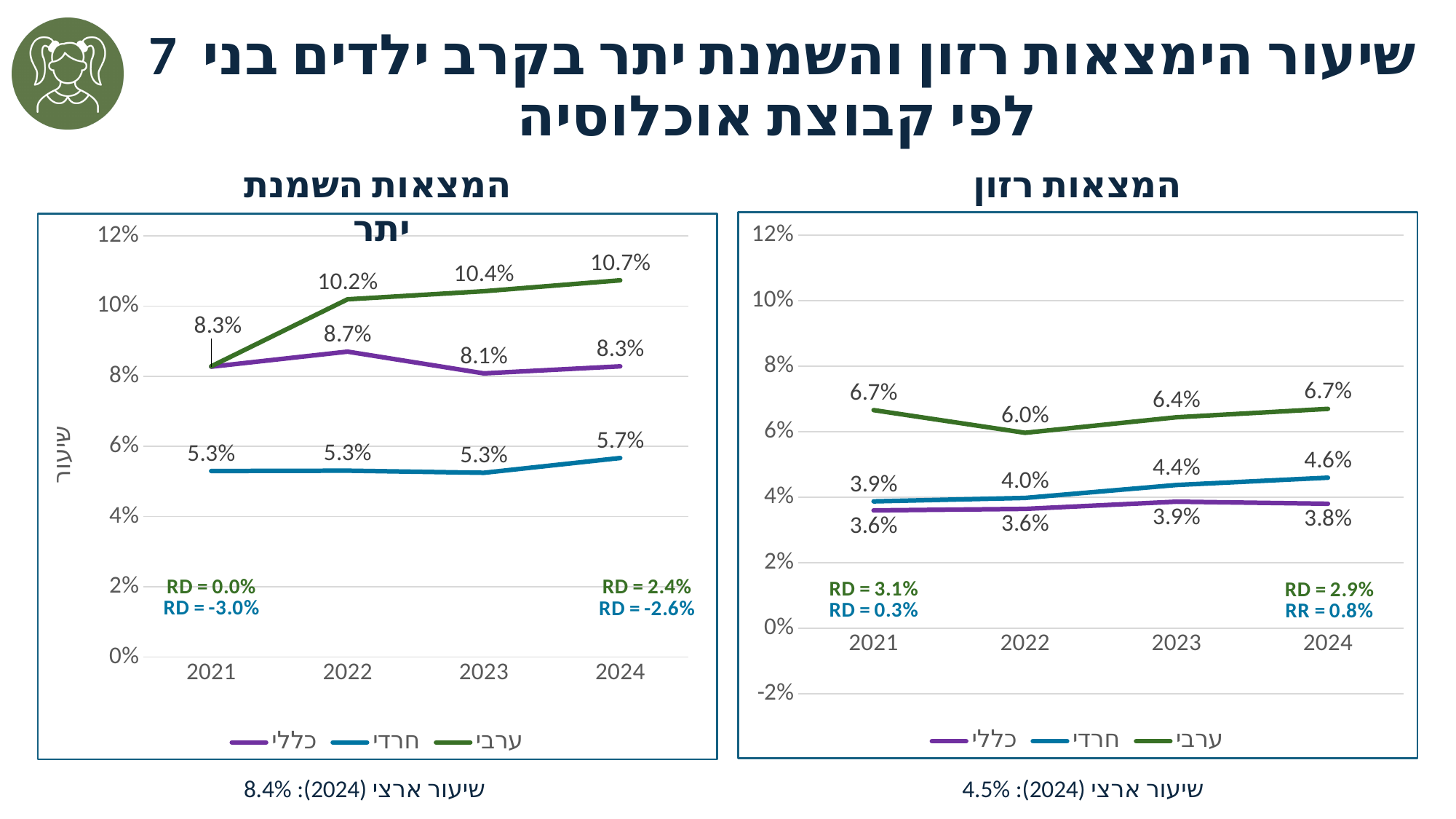
What kind of chart is the right chart (המצאות רזון)? line chart In the left chart (המצאות השמנת יתר), which series has the highest value in 2024? ערבי In the left chart (המצאות השמנת יתר), what is the value for חרדי in 2023? 5.3% In the right chart (המצאות רזון), what is the value for כללי in 2022? 3.6% How many years are shown on the x axis of the right chart (המצאות רזון)? 4 In the right chart (המצאות רזון), what is the value for חרדי in 2024? 4.6% How many series does the legend of the left chart (המצאות השמנת יתר) list? 3 In the left chart (המצאות השמנת יתר), what is the difference between the ערבי and חרדי values in 2024? 5.0% In the right chart (המצאות רזון), which year has the lowest value for ערבי? 2022 In the left chart (המצאות השמנת יתר), what is the value for ערבי in 2024? 10.7% In the left chart (המצאות השמנת יתר), is the value for ערבי in 2022 greater or less than 10%? greater In the right chart (המצאות רזון), which is larger in 2023: the value for חרדי or the value for כללי? חרדי